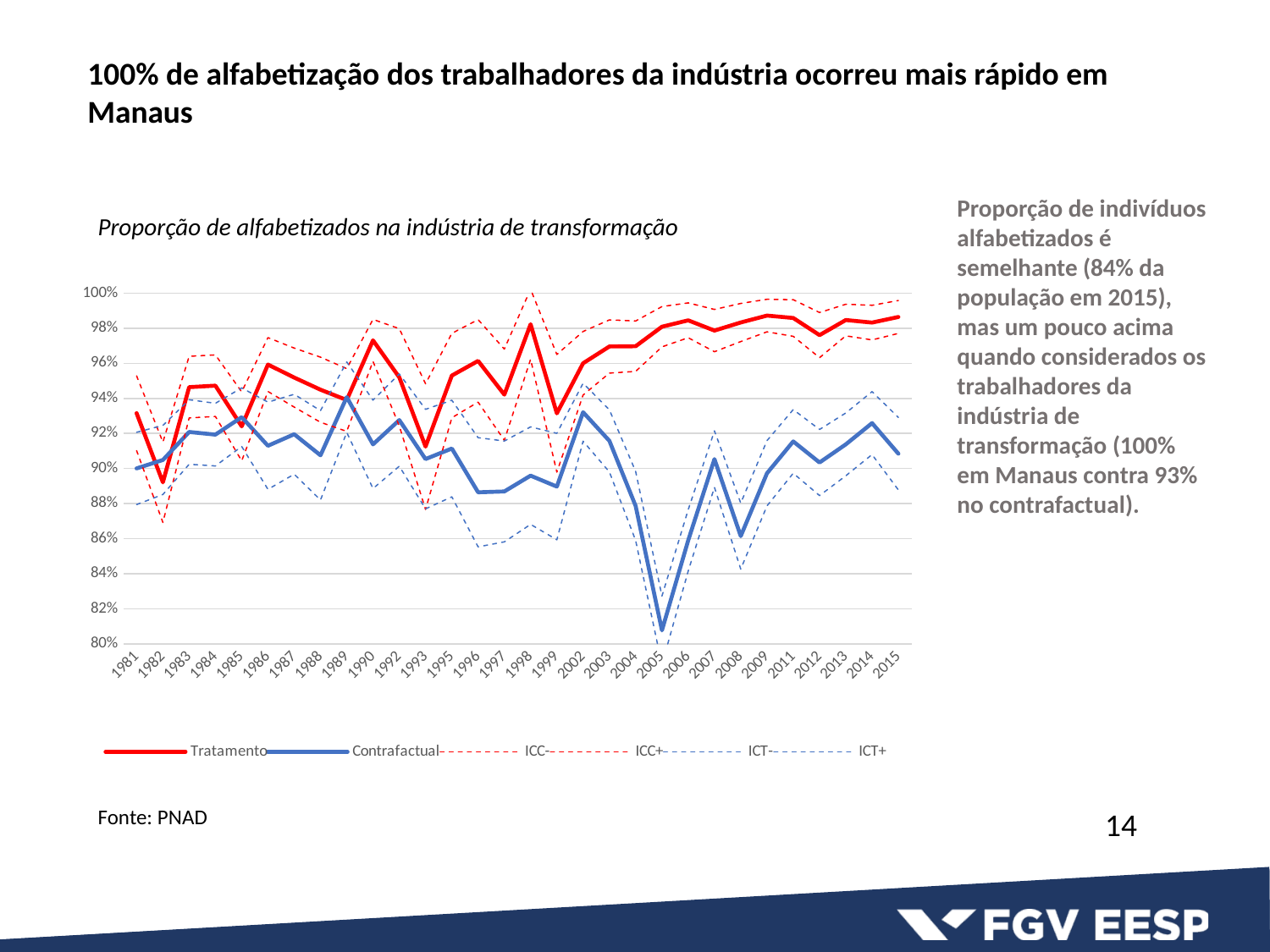
Does the Tratamento series generally rise or fall from 1981 to 2015? Rise Is the value of the Contrafactual series in 2005 greater or less than 82%? less Is the value of the Contrafactual series in 2015 greater or less than 92%? less In which year does the Contrafactual series reach its lowest value? 2005 In 2005, which series has the higher value, Tratamento or Contrafactual? Tratamento Is the value of the Tratamento series in 2015 greater or less than 98%? greater How many years are plotted along the x axis of the chart? 30 How many series does the chart legend list? 6 What is the title of the chart? Proporção de alfabetizados na indústria de transformação What source is cited below the chart? PNAD What kind of chart is shown on the slide? Line chart